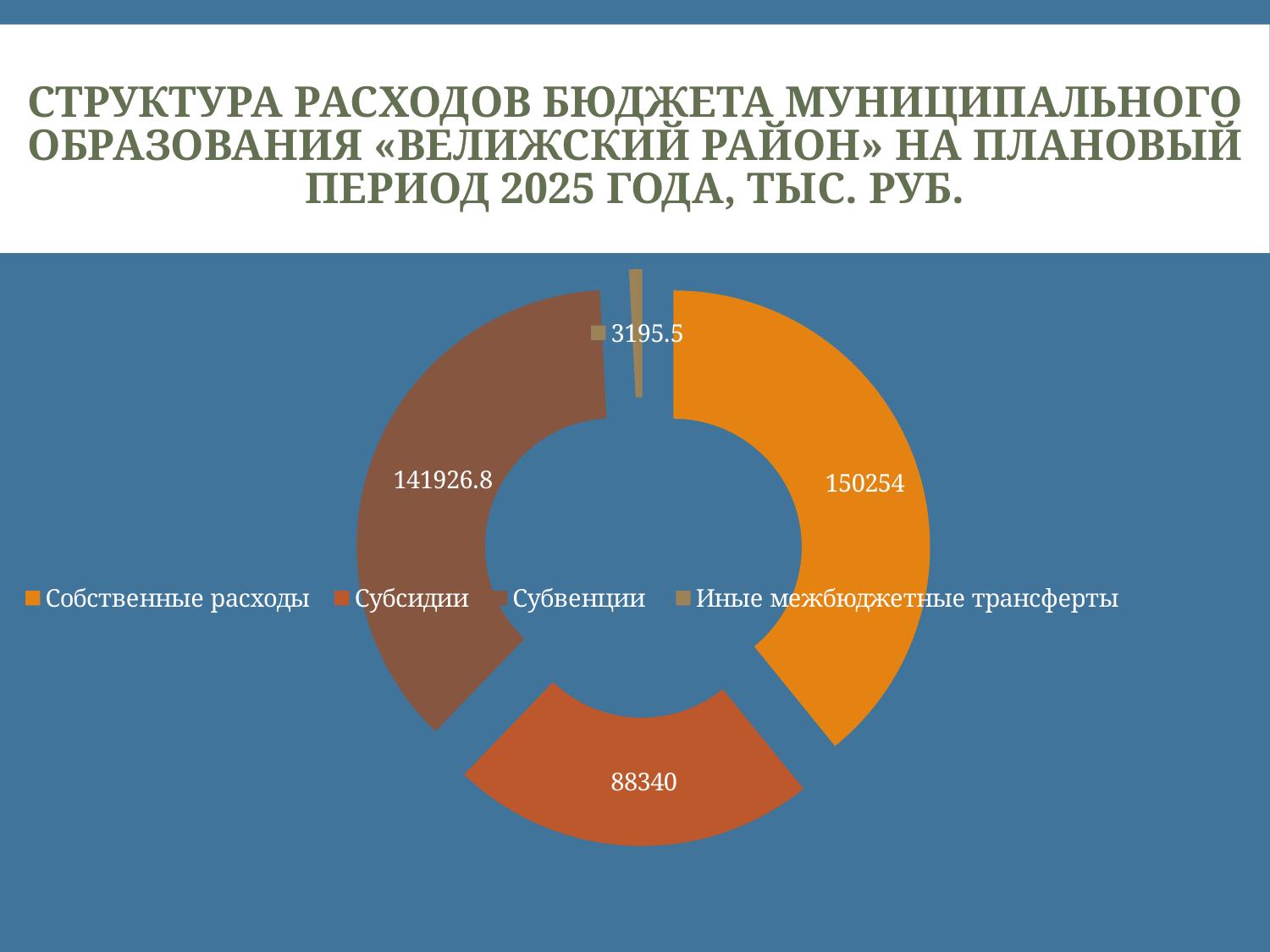
What is the value for Собственные расходы? 150254 How many categories does the chart show? 4 Which is larger, Субсидии or Субвенции? Субвенции Which category has the lowest value? Иные межбюджетные трансферты What is the value for Субвенции? 141926.8 What is the value for Иные межбюджетные трансферты? 3195.5 What kind of chart is shown on the slide? doughnut chart What is the difference between Субвенции and Субсидии? 53586.8 What is the total of all four categories shown in the chart? 383716.3 What is the value for Субсидии? 88340 Which category has the highest value? Собственные расходы What is the difference between Собственные расходы and Субвенции? 8327.2